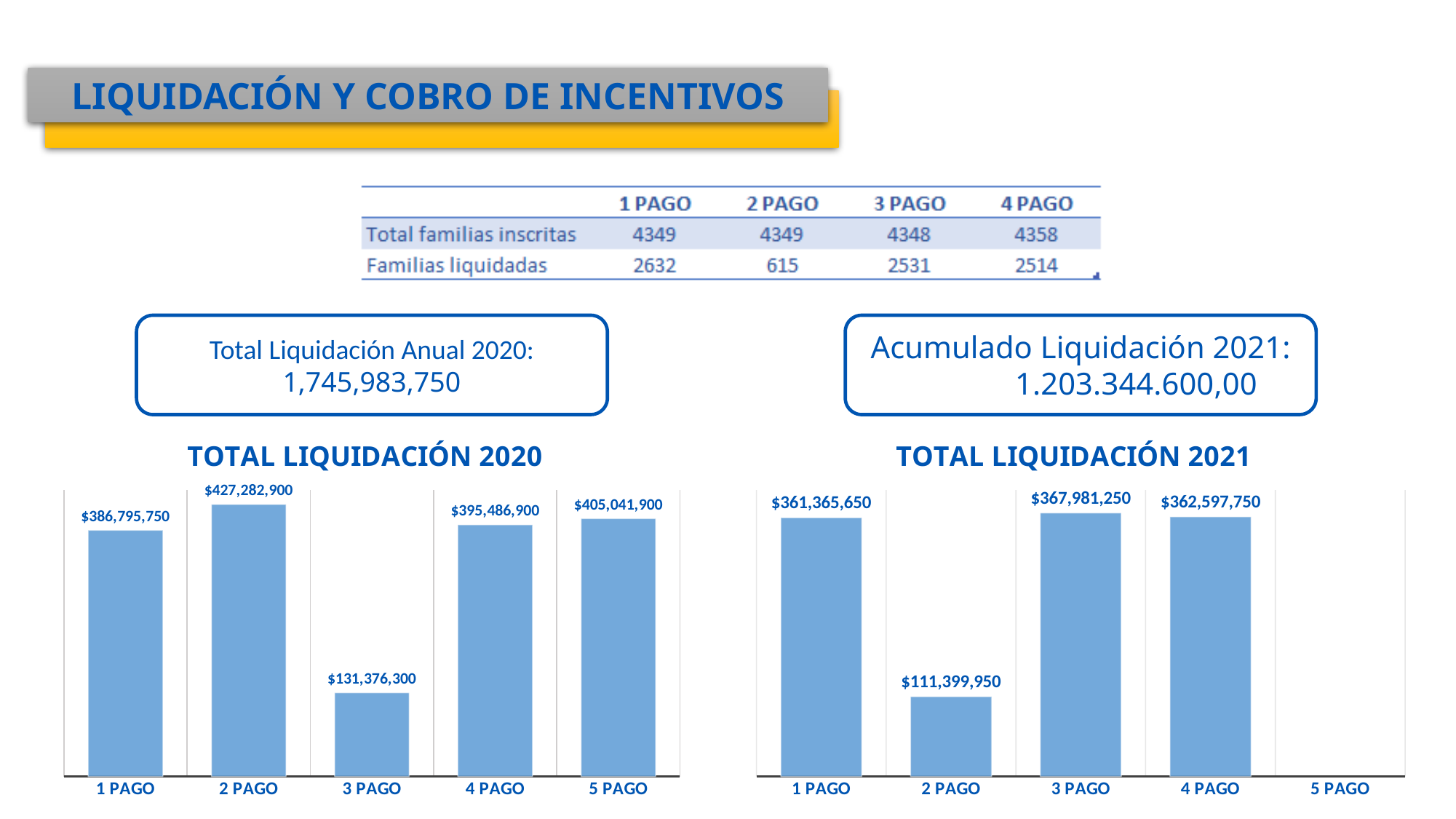
In the TOTAL LIQUIDACIÓN 2020 chart, which category has the lowest value? 3 PAGO In the TOTAL LIQUIDACIÓN 2021 chart, what is the difference between the values for 3 PAGO and 2 PAGO? $256,581,300 What is the title of the chart on the right side of the slide? TOTAL LIQUIDACIÓN 2021 In the TOTAL LIQUIDACIÓN 2021 chart, what is the value for 4 PAGO? $362,597,750 In the TOTAL LIQUIDACIÓN 2021 chart, which category has the lowest value? 2 PAGO In the TOTAL LIQUIDACIÓN 2020 chart, which is larger, the value for 5 PAGO or the value for 4 PAGO? 5 PAGO In the TOTAL LIQUIDACIÓN 2020 chart, what is the difference between the values for 2 PAGO and 3 PAGO? $295,906,600 In the TOTAL LIQUIDACIÓN 2021 chart, which category has the highest value? 3 PAGO In the TOTAL LIQUIDACIÓN 2020 chart, what is the value for 2 PAGO? $427,282,900 In the TOTAL LIQUIDACIÓN 2020 chart, which category has the highest value? 2 PAGO What kind of chart is the TOTAL LIQUIDACIÓN 2020 chart? Bar chart In the TOTAL LIQUIDACIÓN 2021 chart, how many bars have a value shown? 4